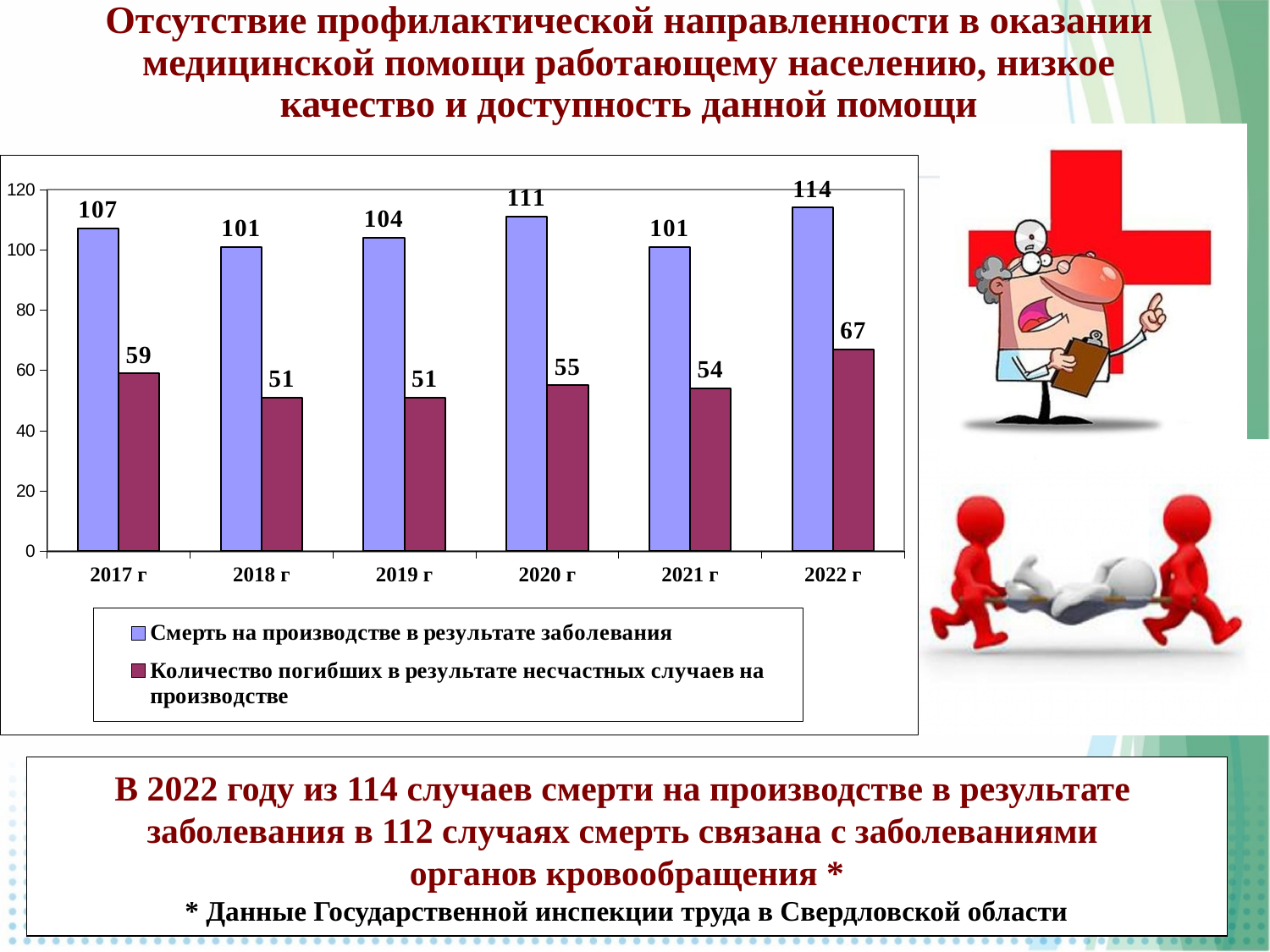
Does 'Количество погибших в результате несчастных случаев на производстве' rise or fall from 2021 г to 2022 г? rise What is the value for 'Смерть на производстве в результате заболевания' in 2022 г? 114 In which year is 'Количество погибших в результате несчастных случаев на производстве' highest? 2022 г Which is larger in 2019 г: 'Смерть на производстве в результате заболевания' or 'Количество погибших в результате несчастных случаев на производстве'? Смерть на производстве в результате заболевания How many series does the legend list? 2 How many years are shown on the x axis? 6 What is the difference between the two series in 2020 г? 56 In which year is 'Смерть на производстве в результате заболевания' highest? 2022 г Is the value for 'Смерть на производстве в результате заболевания' in 2018 г greater or less than 100? greater What kind of chart is shown on the slide? bar chart What is the value for 'Количество погибших в результате несчастных случаев на производстве' in 2017 г? 59 What colour are the bars for 'Смерть на производстве в результате заболевания'? light blue (lavender)